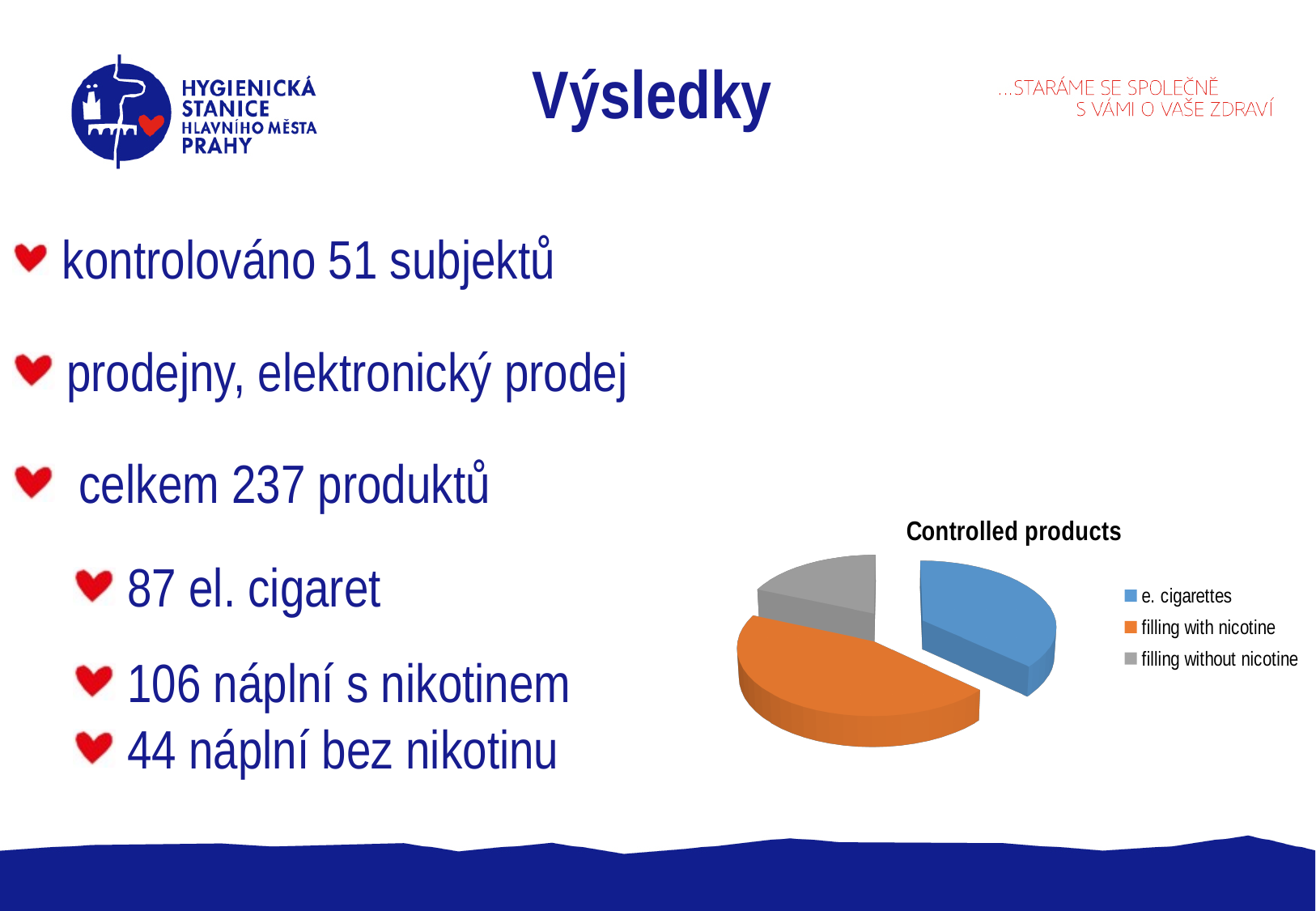
Which category has the smallest slice of the pie? filling without nicotine Which slice is larger: e. cigarettes or filling without nicotine? e. cigarettes How many slices does the pie chart have? 3 Which category has the largest slice of the pie? filling with nicotine Which colour represents e. cigarettes in the pie chart? blue How many entries does the chart legend list? 3 Which slice is larger: filling with nicotine or e. cigarettes? filling with nicotine What kind of chart is shown on the slide? pie chart What is the title of the chart? Controlled products